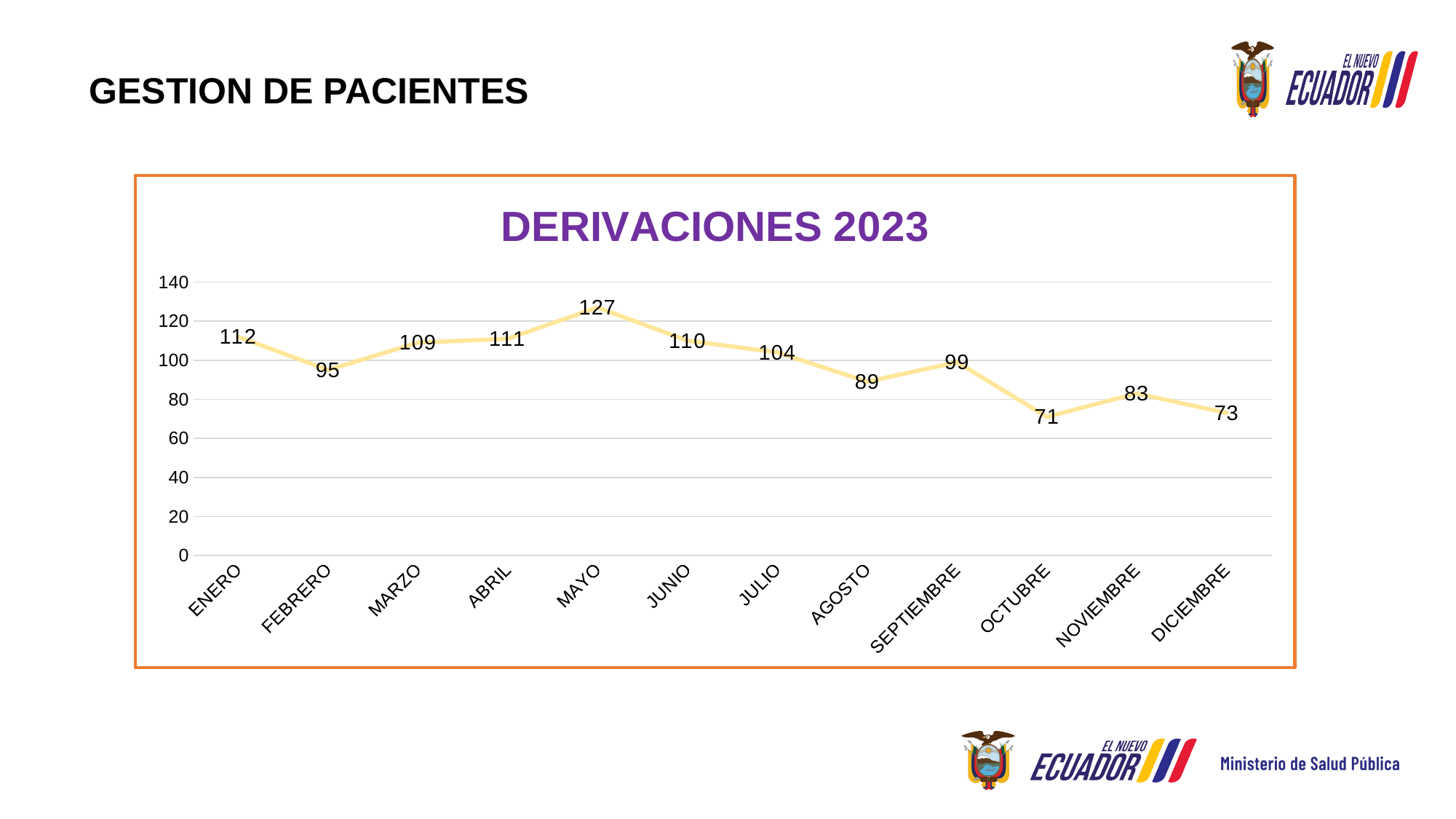
Which is larger in the DERIVACIONES 2023 chart, the value for JUNIO or the value for JULIO? JUNIO What kind of chart is DERIVACIONES 2023? line chart What is the difference between the values for ENERO and FEBRERO in the DERIVACIONES 2023 chart? 17 What is the value for OCTUBRE in the DERIVACIONES 2023 chart? 71 Which month has the highest value in the DERIVACIONES 2023 chart? MAYO Is the value for AGOSTO in the DERIVACIONES 2023 chart greater or less than 100? less Do the values in the DERIVACIONES 2023 chart generally rise or fall from MAYO to DICIEMBRE? fall How many months are plotted in the DERIVACIONES 2023 chart? 12 What is the value for ENERO in the DERIVACIONES 2023 chart? 112 What is the difference between the values for MAYO and OCTUBRE in the DERIVACIONES 2023 chart? 56 Which month has the lowest value in the DERIVACIONES 2023 chart? OCTUBRE What is the value for MAYO in the DERIVACIONES 2023 chart? 127